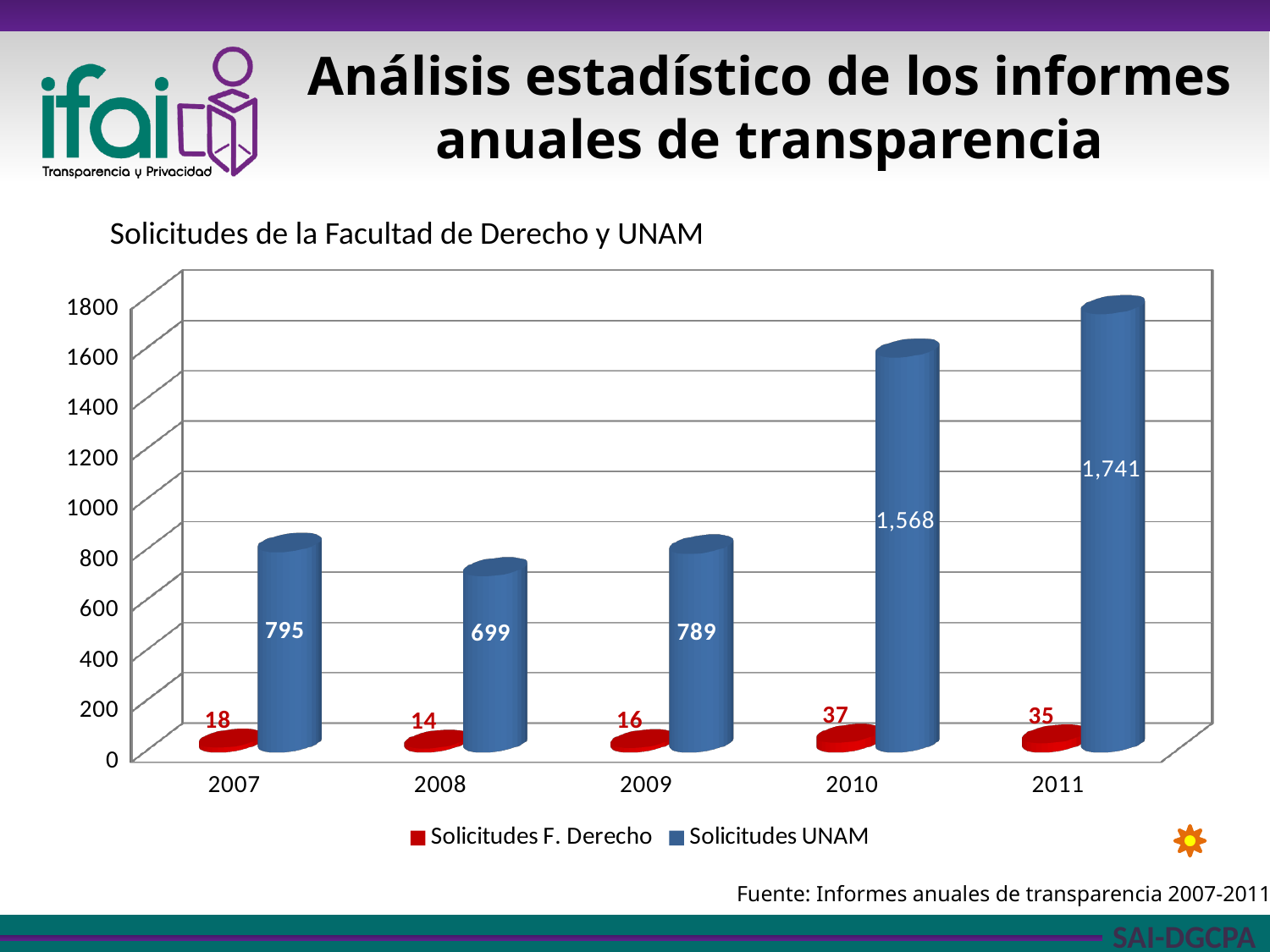
What kind of chart is shown on the slide? bar chart How many years are shown on the x axis? 5 What colour are the bars for Solicitudes UNAM? blue What is the value for Solicitudes UNAM in 2007? 795 What is the value for Solicitudes UNAM in 2010? 1,568 What is the value for Solicitudes F. Derecho in 2008? 14 How many series does the legend list? 2 Is the value for Solicitudes UNAM in 2009 greater or less than 1000? less Which year has the lowest value for Solicitudes F. Derecho? 2008 Which is larger, Solicitudes F. Derecho in 2010 or in 2011? 2010 What is the difference between Solicitudes UNAM in 2011 and in 2010? 173 Which year has the highest value for Solicitudes UNAM? 2011